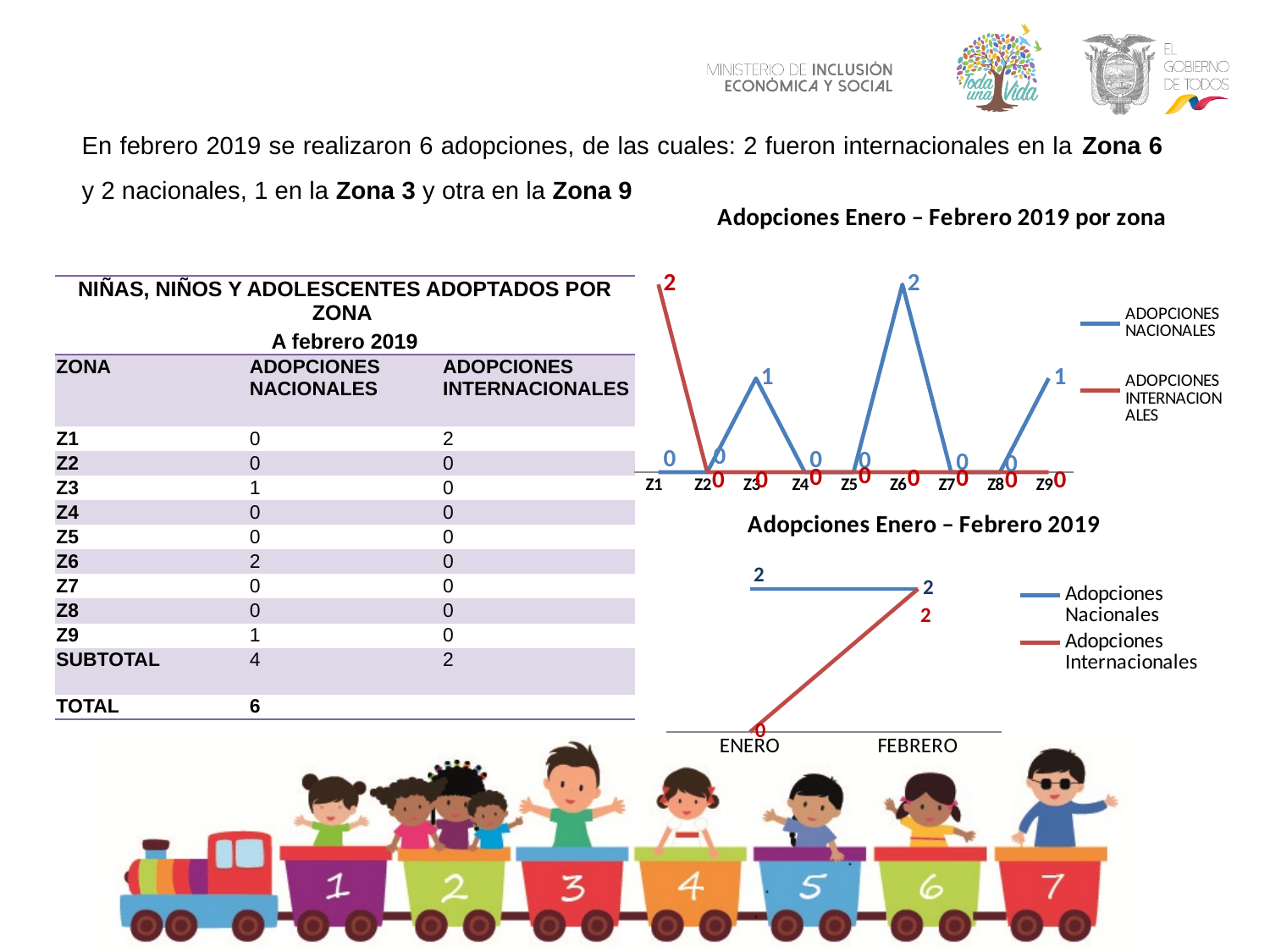
In the chart 'Adopciones Enero – Febrero 2019 por zona', which zone has the highest value for ADOPCIONES INTERNACIONALES? Z1 In the chart 'Adopciones Enero – Febrero 2019', what is the value of Adopciones Internacionales for ENERO? 0 In the chart 'Adopciones Enero – Febrero 2019', what is the value of Adopciones Nacionales for FEBRERO? 2 In the chart 'Adopciones Enero – Febrero 2019 por zona', how many zones are shown on the x axis? 9 In the chart 'Adopciones Enero – Febrero 2019 por zona', what is the value of ADOPCIONES NACIONALES for Z6? 2 In the chart 'Adopciones Enero – Febrero 2019 por zona', which zone has the highest value for ADOPCIONES NACIONALES? Z6 In the chart 'Adopciones Enero – Febrero 2019 por zona', how many series does the legend list? 2 In the chart 'Adopciones Enero – Febrero 2019 por zona', what is the value of ADOPCIONES NACIONALES for Z9? 1 What kind of chart is 'Adopciones Enero – Febrero 2019'? line chart In the chart 'Adopciones Enero – Febrero 2019 por zona', what is the value of ADOPCIONES INTERNACIONALES for Z1? 2 In the chart 'Adopciones Enero – Febrero 2019 por zona', what is the difference between ADOPCIONES NACIONALES for Z6 and for Z3? 1 In the chart 'Adopciones Enero – Febrero 2019', do the values for Adopciones Internacionales rise or fall from ENERO to FEBRERO? rise